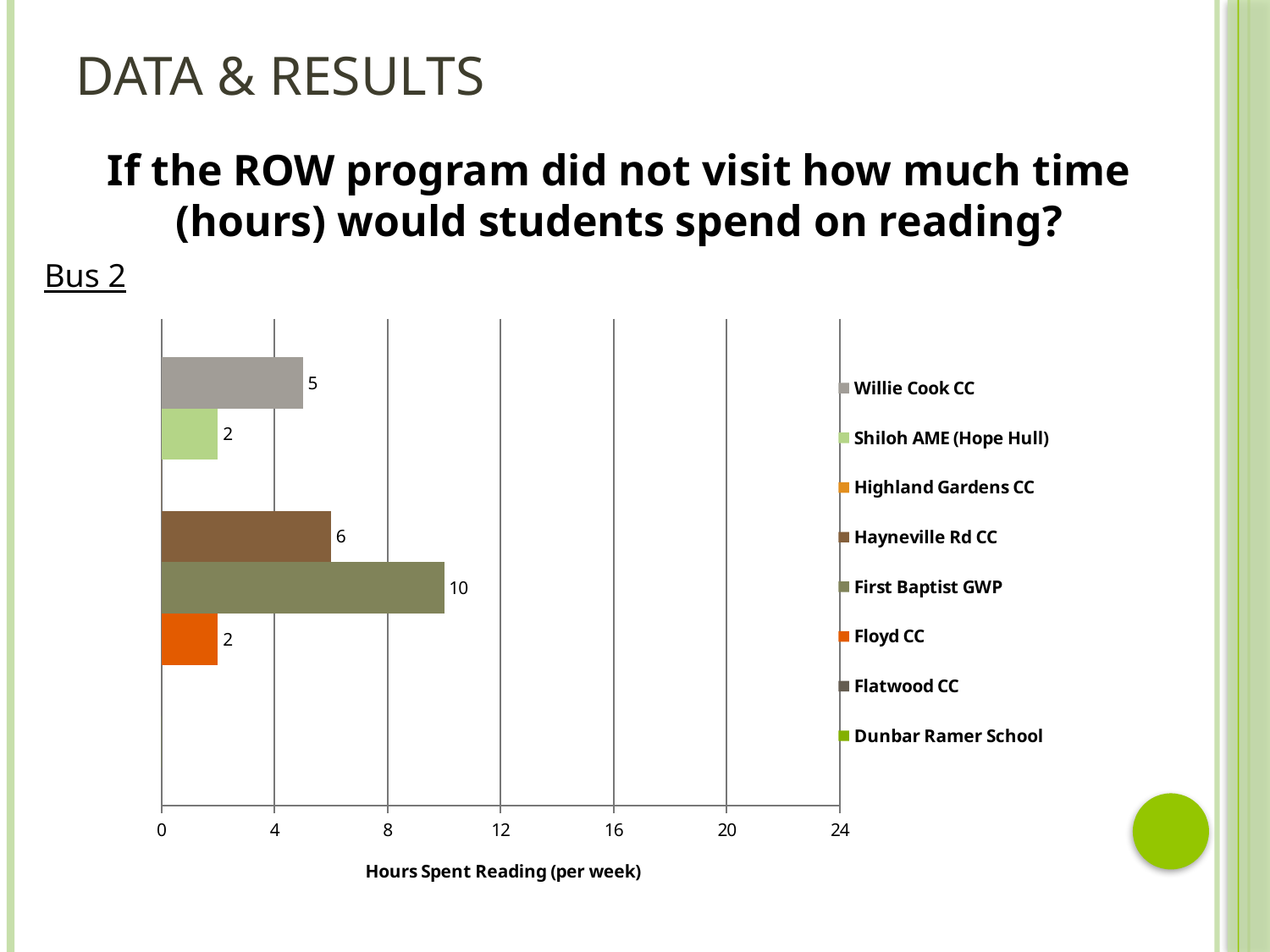
What value is shown for Shiloh AME (Hope Hull)? 2 What value is shown for Hayneville Rd CC? 6 Which series has the highest value on the chart? First Baptist GWP What kind of chart is shown on the slide? Bar chart What is the difference between the values for First Baptist GWP and Hayneville Rd CC? 4 What value is shown for Willie Cook CC? 5 What value is shown for Floyd CC? 2 What is the title of the horizontal axis? Hours Spent Reading (per week) What is the difference between the values for Willie Cook CC and Floyd CC? 3 What value is shown for First Baptist GWP? 10 Which is larger, the value for Hayneville Rd CC or the value for Willie Cook CC? Hayneville Rd CC How many series does the legend list? 8